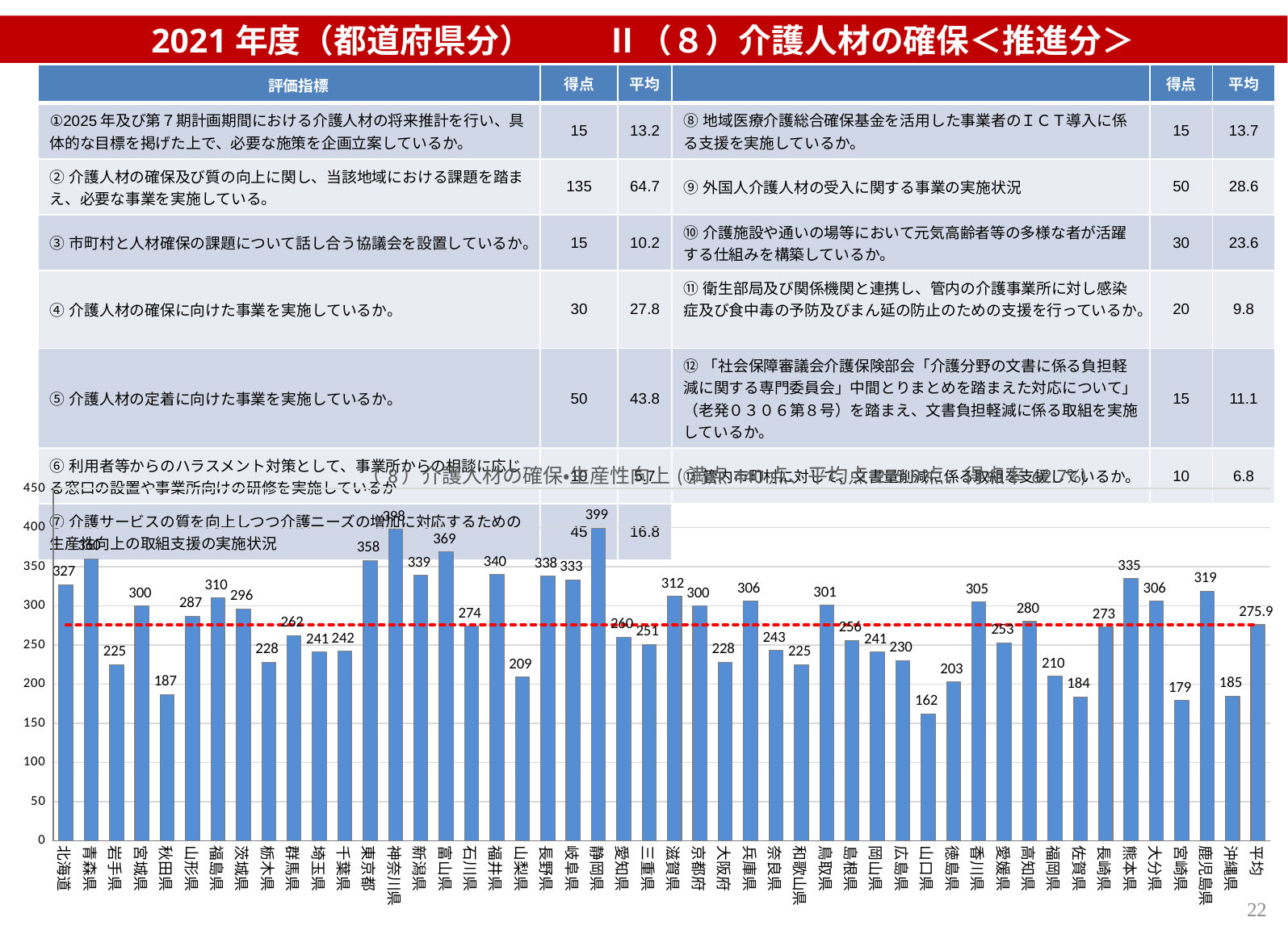
What is the value for 山口県 in the bar chart? 162 What is the value for 北海道 in the bar chart? 327 What kind of chart is shown at the bottom of the slide? bar chart What is the value for 熊本県 in the bar chart? 335 Is the value for 宮崎県 greater or less than 200 in the bar chart? less What does the red dashed horizontal line in the bar chart represent? the average (平均), 275.9 What is the difference between the values for 東京都 and 秋田県 in the bar chart? 171 Which has a larger value in the bar chart, 富山県 or 新潟県? 富山県 Is the value for 鹿児島県 greater or less than 300 in the bar chart? greater What is the value for 静岡県 in the bar chart? 399 Which prefecture has the lowest value in the bar chart? 山口県 What is the value shown for 平均 (the last bar) in the bar chart? 275.9